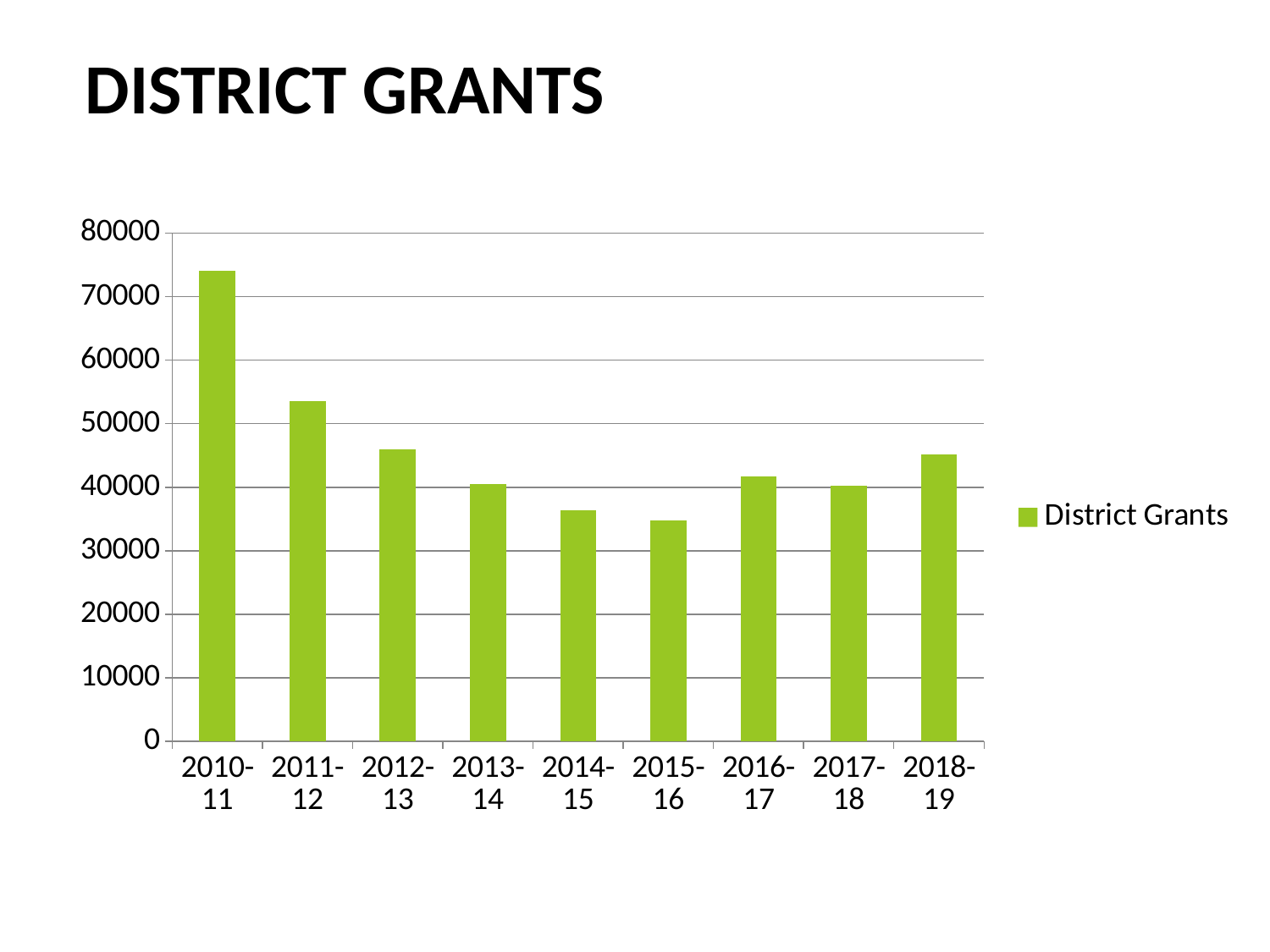
Which year has the highest value for District Grants? 2010-11 What kind of chart is shown on the slide? Bar chart Do the values rise or fall from 2010-11 to 2015-16? fall Is the value for 2010-11 greater or less than 70000? greater Which is larger, the value for 2012-13 or the value for 2015-16? 2012-13 Which year has the lowest value for District Grants? 2015-16 Is the value for 2011-12 greater or less than 50000? greater How many series does the legend list? 1 Is the value for 2015-16 greater or less than 40000? less What is the name of the series shown in the legend? District Grants How many year categories are shown on the x axis? 9